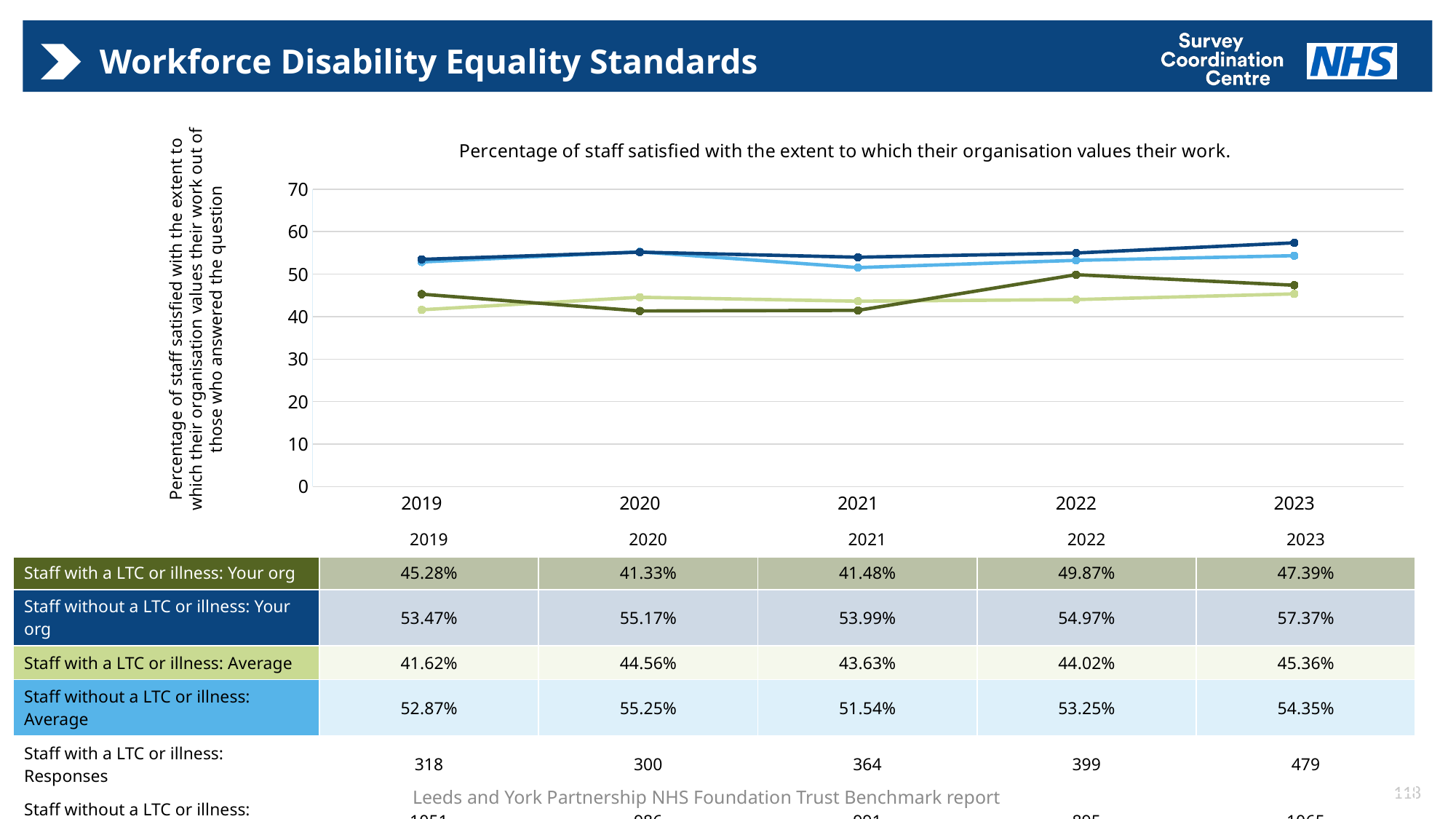
In which year is the value for Staff without a LTC or illness: Your org highest? 2023 What is the value for Staff with a LTC or illness: Your org in 2022? 49.87% Does the value for Staff without a LTC or illness: Your org rise or fall from 2022 to 2023? Rise What is the difference between Staff without a LTC or illness: Your org and Staff with a LTC or illness: Your org in 2023? 9.98 percentage points In which year is the value for Staff with a LTC or illness: Your org lowest? 2020 What kind of chart is shown on the slide? Line chart What is the value for Staff with a LTC or illness: Average in 2021? 43.63% What is the value for Staff without a LTC or illness: Your org in 2023? 57.37% In 2020, which is larger: Staff without a LTC or illness: Your org or Staff without a LTC or illness: Average? Staff without a LTC or illness: Average Is the value for Staff with a LTC or illness: Your org in 2022 greater or less than 40? greater How many years are shown on the x axis of the chart? 5 How many series are plotted on the chart? 4